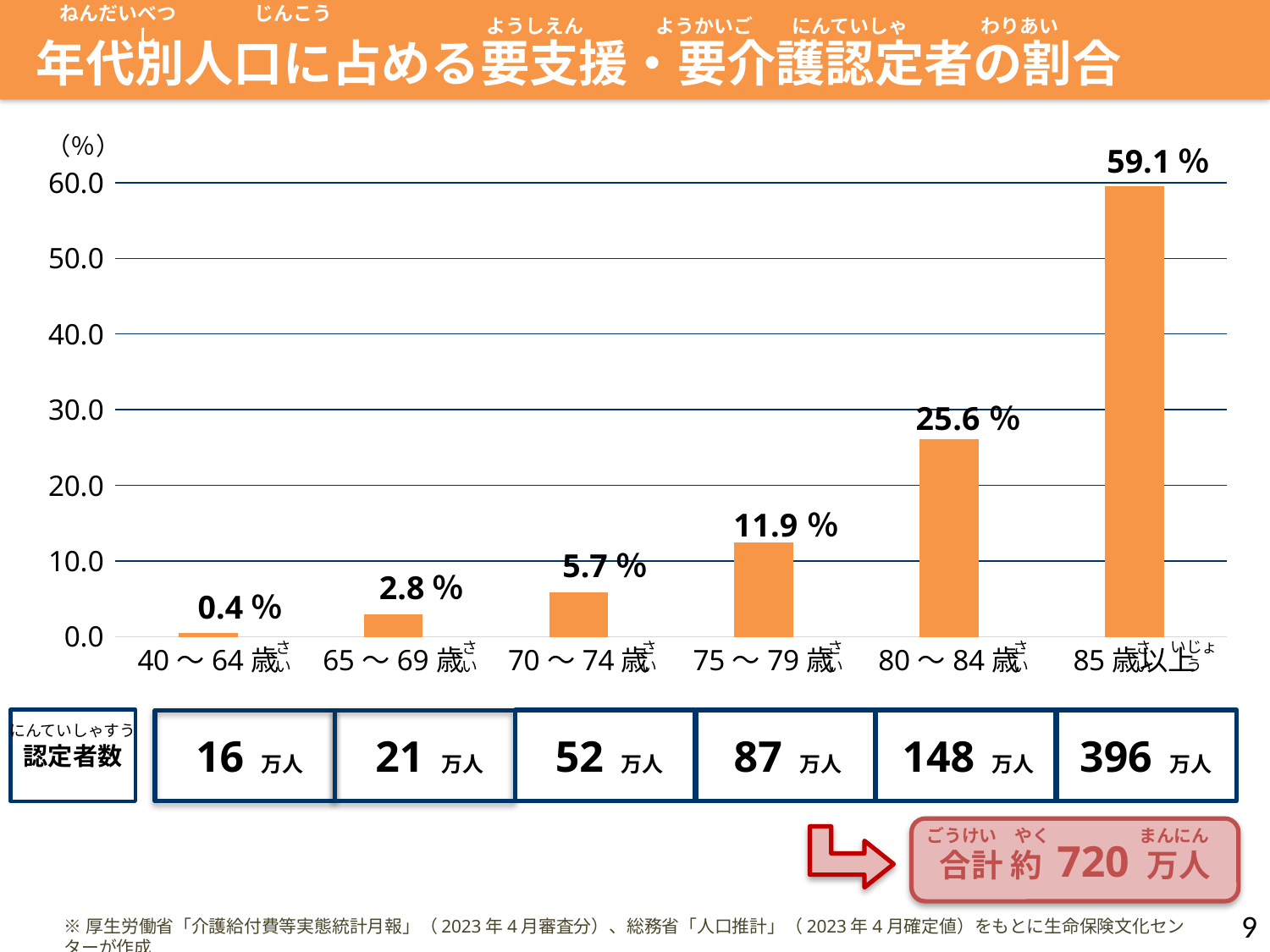
What is the difference between the values for 75～79歳 and 70～74歳? 6.2 % What kind of chart is shown on the slide? bar chart Is the value for 80～84歳 greater or less than 20.0? greater Which age group has the lowest value? 40～64歳 What is the difference between the values for 85歳以上 and 80～84歳? 33.5 % What is the value for the 75～79歳 age group? 11.9 % Do the values rise or fall as the age groups move from left to right along the x axis? rise Which is larger, the value for 65～69歳 or the value for 70～74歳? 70～74歳 Which age group has the highest value? 85歳以上 How many age groups are shown on the chart? 6 What is the value for the 85歳以上 age group? 59.1 % What is the value for the 40～64歳 age group? 0.4 %